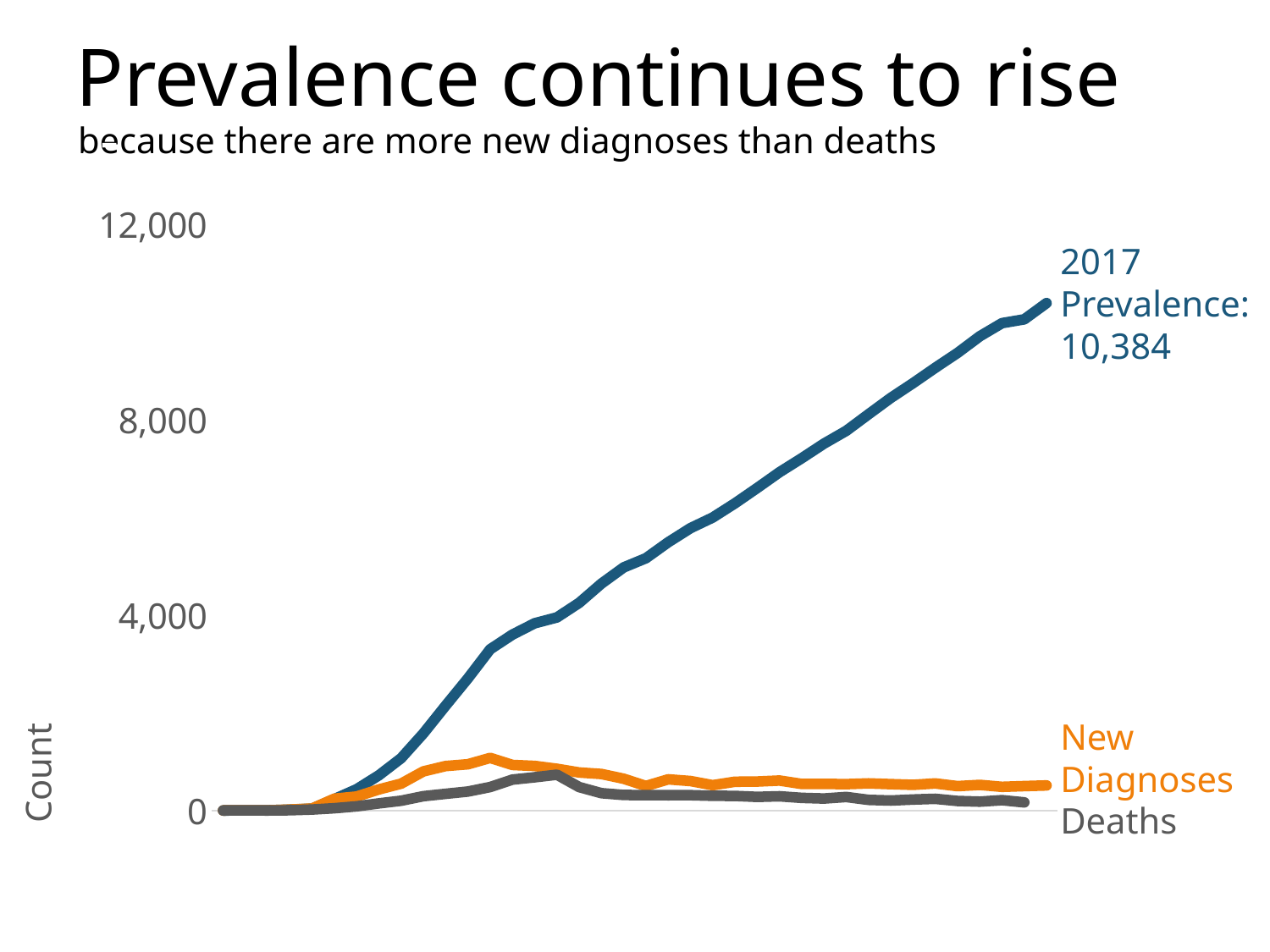
Does the Prevalence line rise or fall along the x axis? rise What is the title of the slide? Prevalence continues to rise How many series are plotted on the chart? 3 What is the label on the y axis? Count What kind of chart is shown on the slide? line chart What is the 2017 prevalence value labelled on the chart? 10,384 At the right end of the chart, which is higher: New Diagnoses or Deaths? New Diagnoses Is the 2017 Prevalence value greater or less than 12,000? less Which series reaches the highest value on the chart? Prevalence Is the 2017 Prevalence value greater or less than 8,000? greater Is the peak of the New Diagnoses line greater or less than 4,000? less